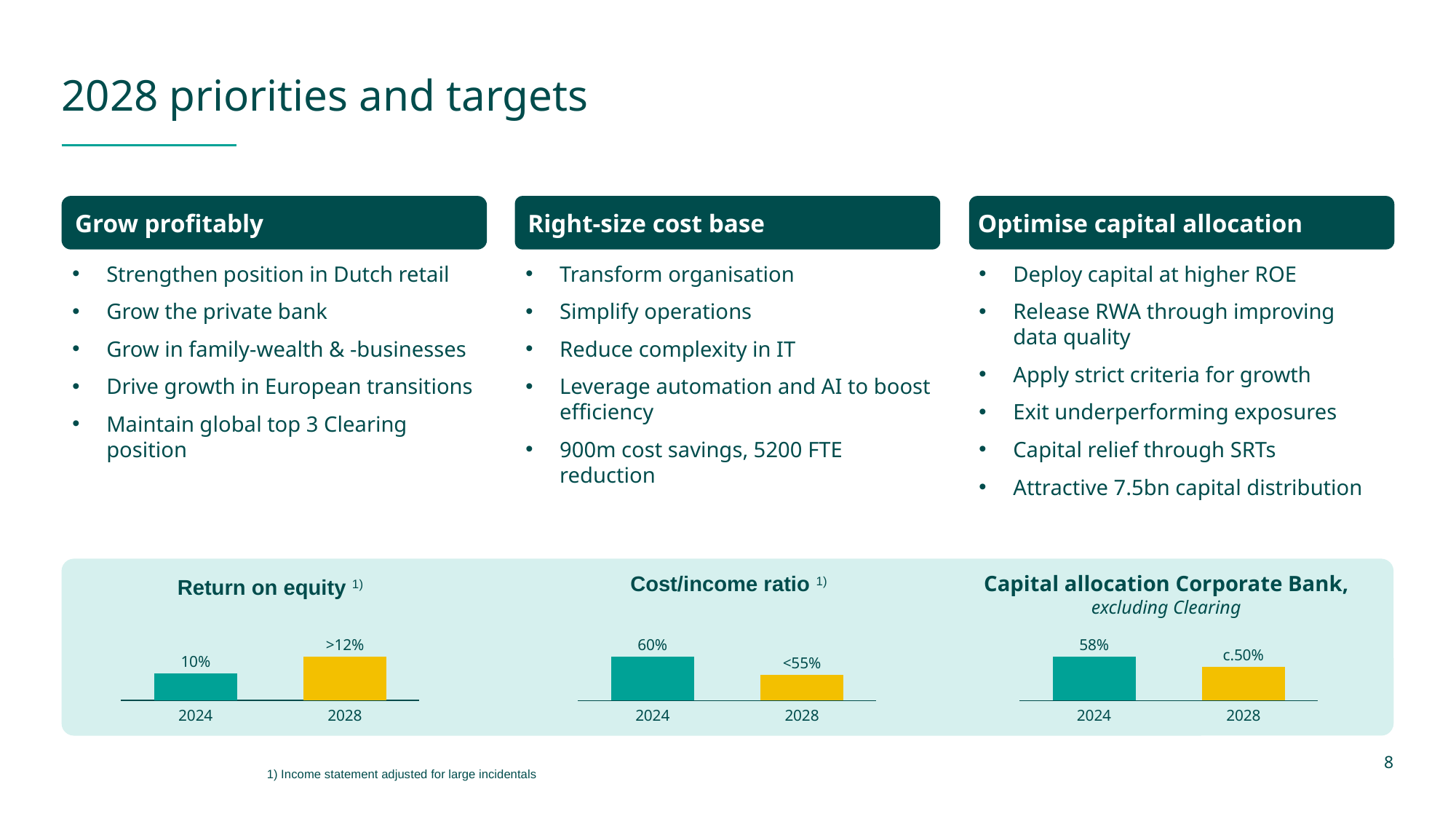
What kind of chart is the Cost/income ratio chart? bar chart In the Return on equity chart, which year has the higher bar, 2024 or 2028? 2028 In the Return on equity chart, what is the value shown for 2028? >12% In the Capital allocation Corporate Bank, excluding Clearing chart, which year has the higher bar? 2024 In the Cost/income ratio chart, what is the value for 2024? 60% How many bars does the Return on equity chart show? 2 In the Cost/income ratio chart, which year has the lower bar? 2028 In the Cost/income ratio chart, what is the value shown for 2028? <55% In the Return on equity chart, what is the value for 2024? 10% In the Capital allocation Corporate Bank, excluding Clearing chart, what is the value shown for 2028? c.50% In the Capital allocation Corporate Bank, excluding Clearing chart, what is the value for 2024? 58% In the Cost/income ratio chart, do the values rise or fall from 2024 to 2028? fall